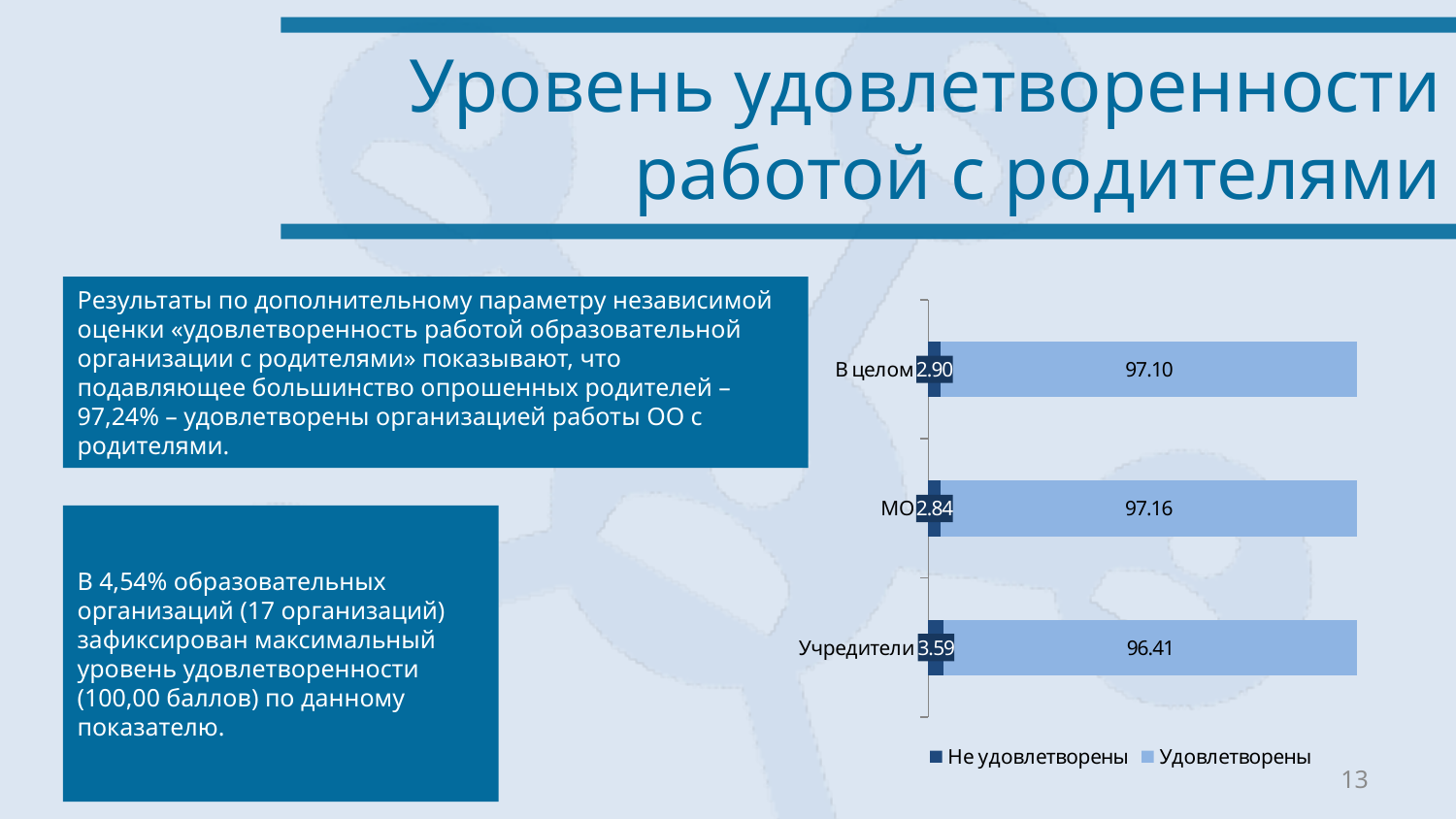
Which category has the lowest «Удовлетворены» value? Учредители What kind of chart is shown on the slide? bar chart What is the difference between the «Удовлетворены» values for «МО» and «Учредители»? 0.75 What is the value of «Удовлетворены» for «Учредители»? 96.41 How many series does the legend list? 2 Which category has the highest «Не удовлетворены» value? Учредители What is the value of «Не удовлетворены» for «Учредители»? 3.59 What is the total of the stacked bar for «В целом»? 100.00 What is the value of «Не удовлетворены» for «МО»? 2.84 Which series is shown in dark blue in the legend? Не удовлетворены What is the value of «Удовлетворены» for «В целом»? 97.10 How many categories does the chart show? 3